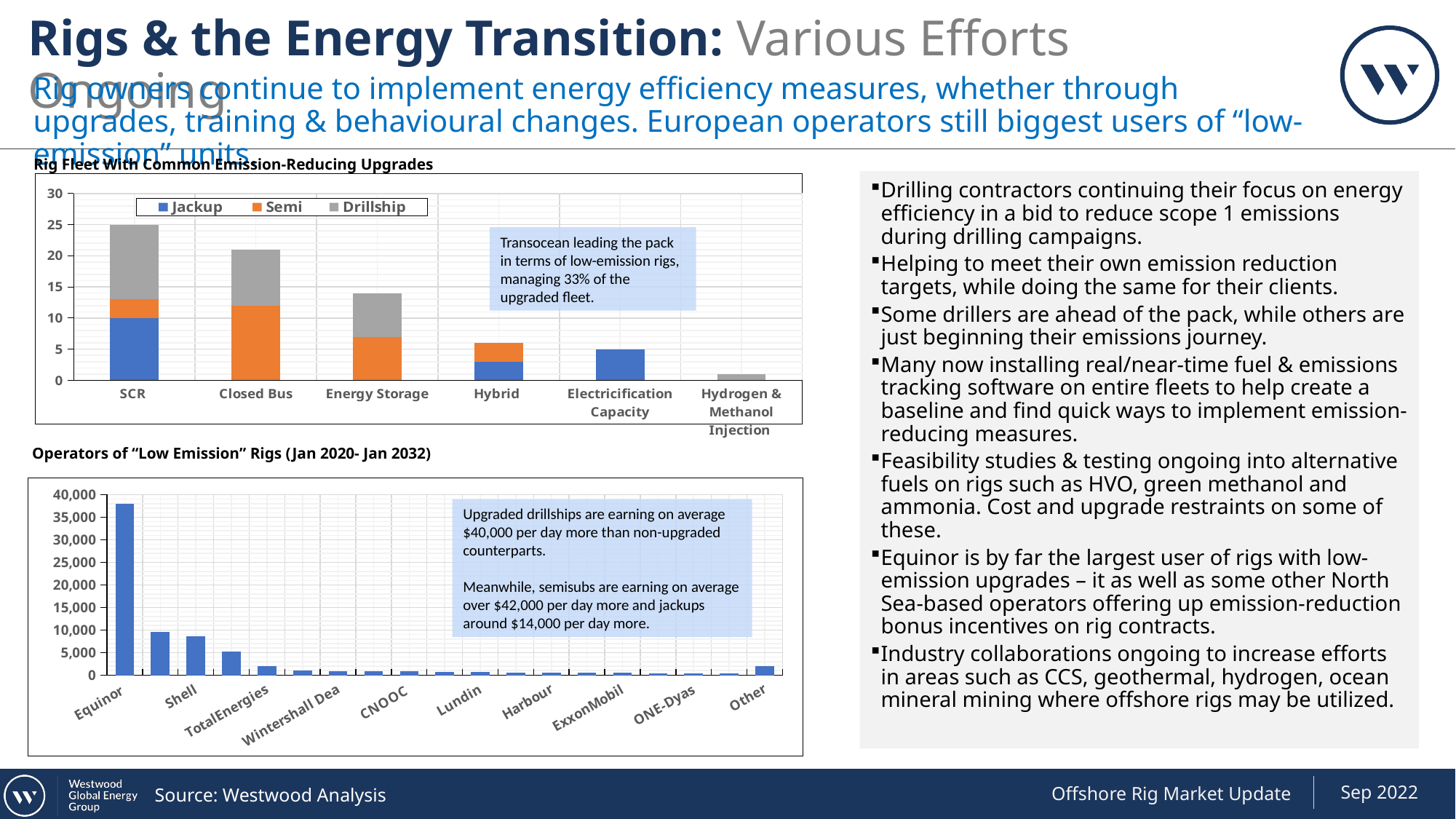
What are the legend entries in the 'Rig Fleet With Common Emission-Reducing Upgrades' chart? Jackup, Semi, Drillship How many series does the legend of the 'Rig Fleet With Common Emission-Reducing Upgrades' chart list? 3 In the 'Operators of "Low Emission" Rigs (Jan 2020- Jan 2032)' chart, is the value for Equinor greater or less than 35,000? greater What kind of chart is the 'Rig Fleet With Common Emission-Reducing Upgrades' chart? Stacked bar chart In the 'Rig Fleet With Common Emission-Reducing Upgrades' chart, which category has the shortest bar? Hydrogen & Methanol Injection In the 'Rig Fleet With Common Emission-Reducing Upgrades' chart, which category has the tallest stacked bar? SCR In the 'Rig Fleet With Common Emission-Reducing Upgrades' chart, is the total for SCR greater or less than 20? greater In the 'Operators of "Low Emission" Rigs (Jan 2020- Jan 2032)' chart, which operator has the highest value? Equinor In the 'Operators of "Low Emission" Rigs (Jan 2020- Jan 2032)' chart, do the values generally rise or fall from Equinor towards ONE-Dyas along the x axis? fall In the 'Rig Fleet With Common Emission-Reducing Upgrades' chart, which has the larger total, Closed Bus or Energy Storage? Closed Bus How many upgrade categories are shown on the x axis of the 'Rig Fleet With Common Emission-Reducing Upgrades' chart? 6 In the 'Rig Fleet With Common Emission-Reducing Upgrades' chart, is the total for Hybrid greater or less than 10? less